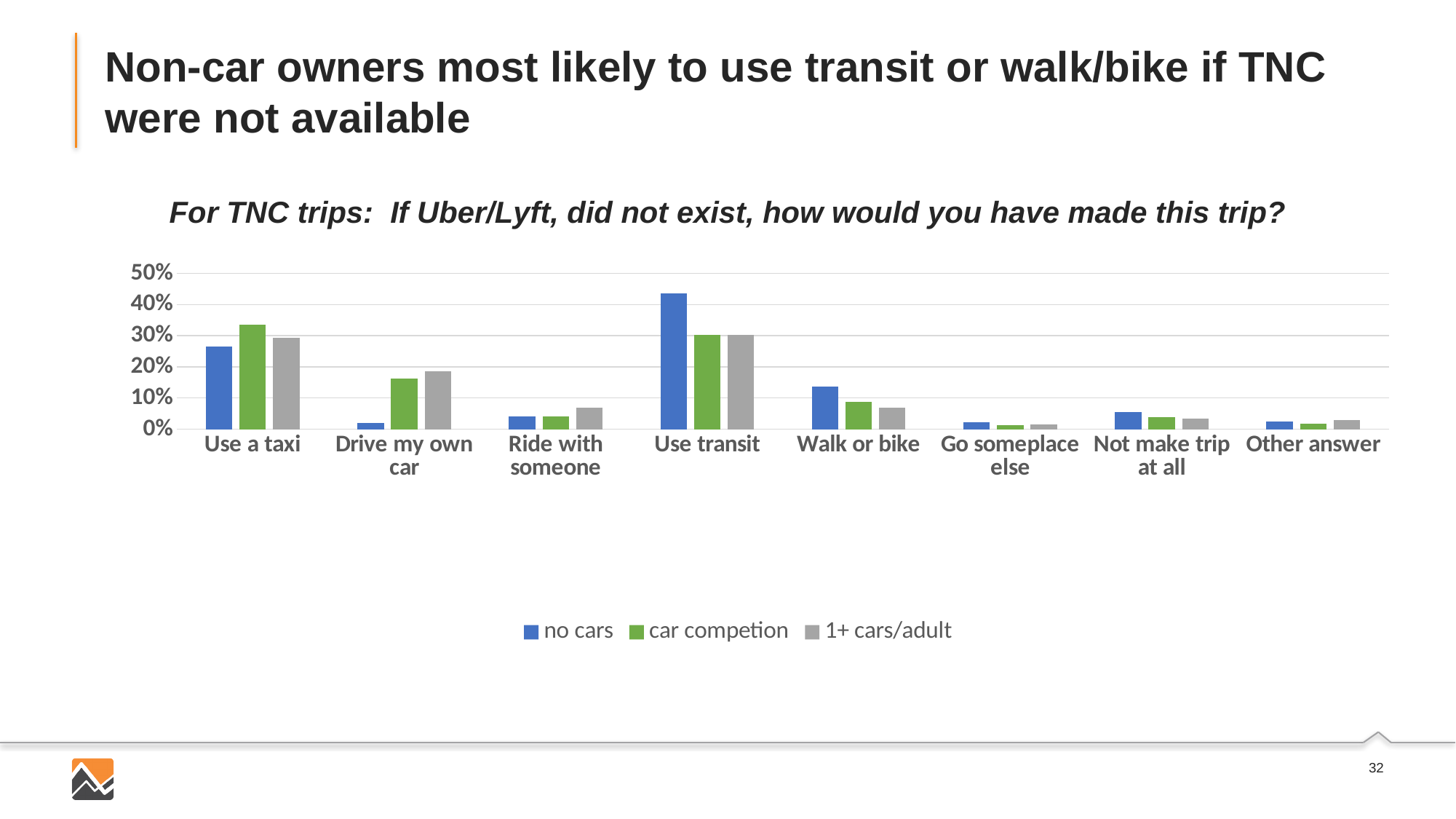
How many response categories are shown along the x axis? 8 Is the 'no cars' value for 'Use transit' greater or less than 40%? greater What kind of chart is shown on the slide? bar chart What are the three series named in the legend? no cars, car competion, 1+ cars/adult For 'Use transit', which is larger: the 'no cars' value or the 'car competion' value? no cars For the 'no cars' series, which category has the highest value? Use transit Is the 'car competion' value for 'Use a taxi' greater or less than 30%? greater Within the 'Use a taxi' category, which series has the highest bar? car competion Is the 'no cars' value for 'Drive my own car' greater or less than 10%? less How many series does the legend list? 3 For 'Drive my own car', which is larger: the 'no cars' value or the '1+ cars/adult' value? 1+ cars/adult